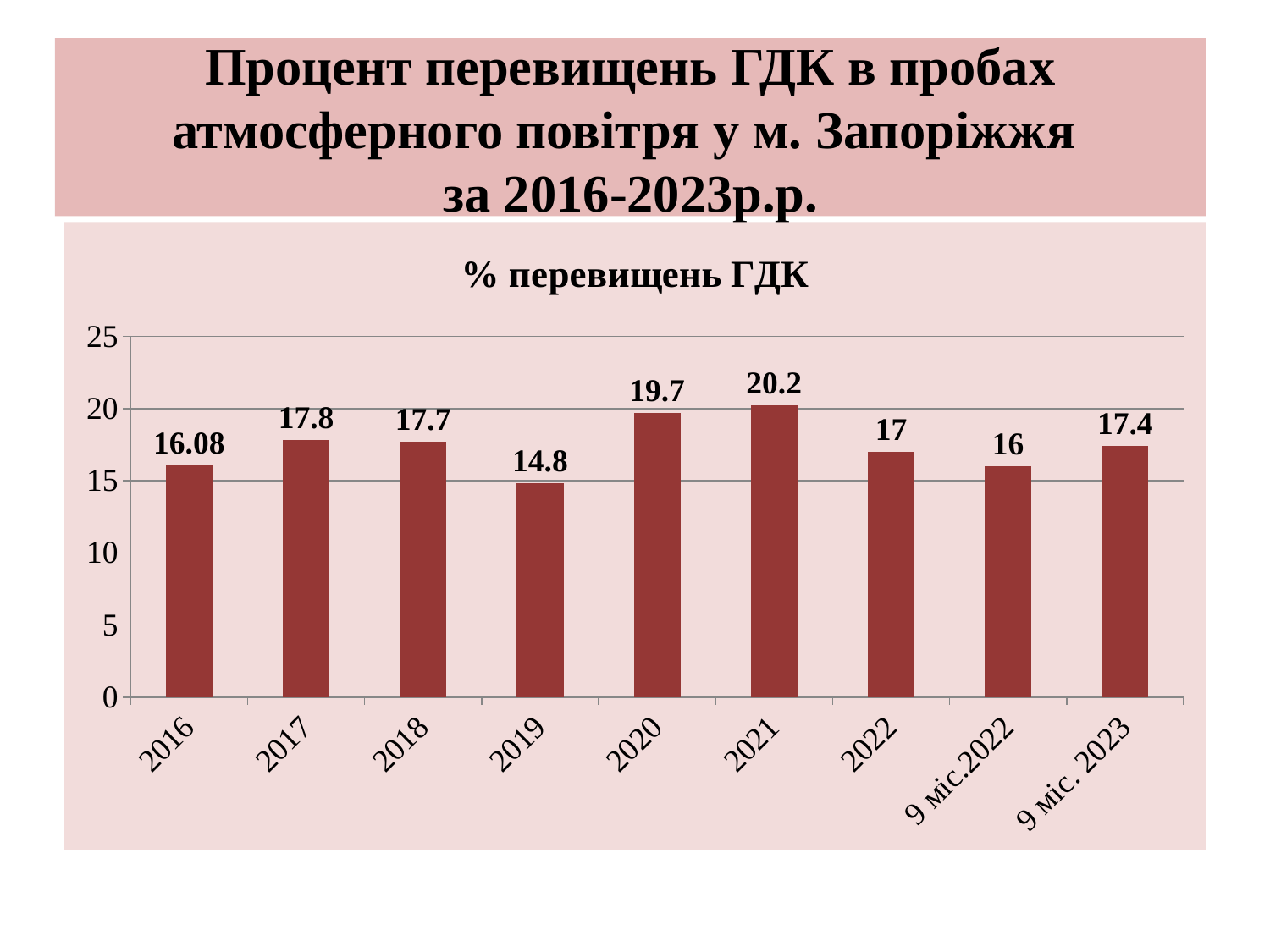
What is the value for 9 міс. 2023? 17.4 Which is larger, the value for 2020 or the value for 2022? 2020 Is the value for 2021 greater or less than 20? greater What is the difference between the values for 2021 and 2019? 5.4 What is the value for 2019? 14.8 What kind of chart is this? bar chart How many categories are shown on the x axis? 9 What is the value for 2016? 16.08 What is the title of the chart? % перевищень ГДК Which category has the highest value? 2021 Do the values rise or fall from 2019 to 2021? rise Which category has the lowest value? 2019